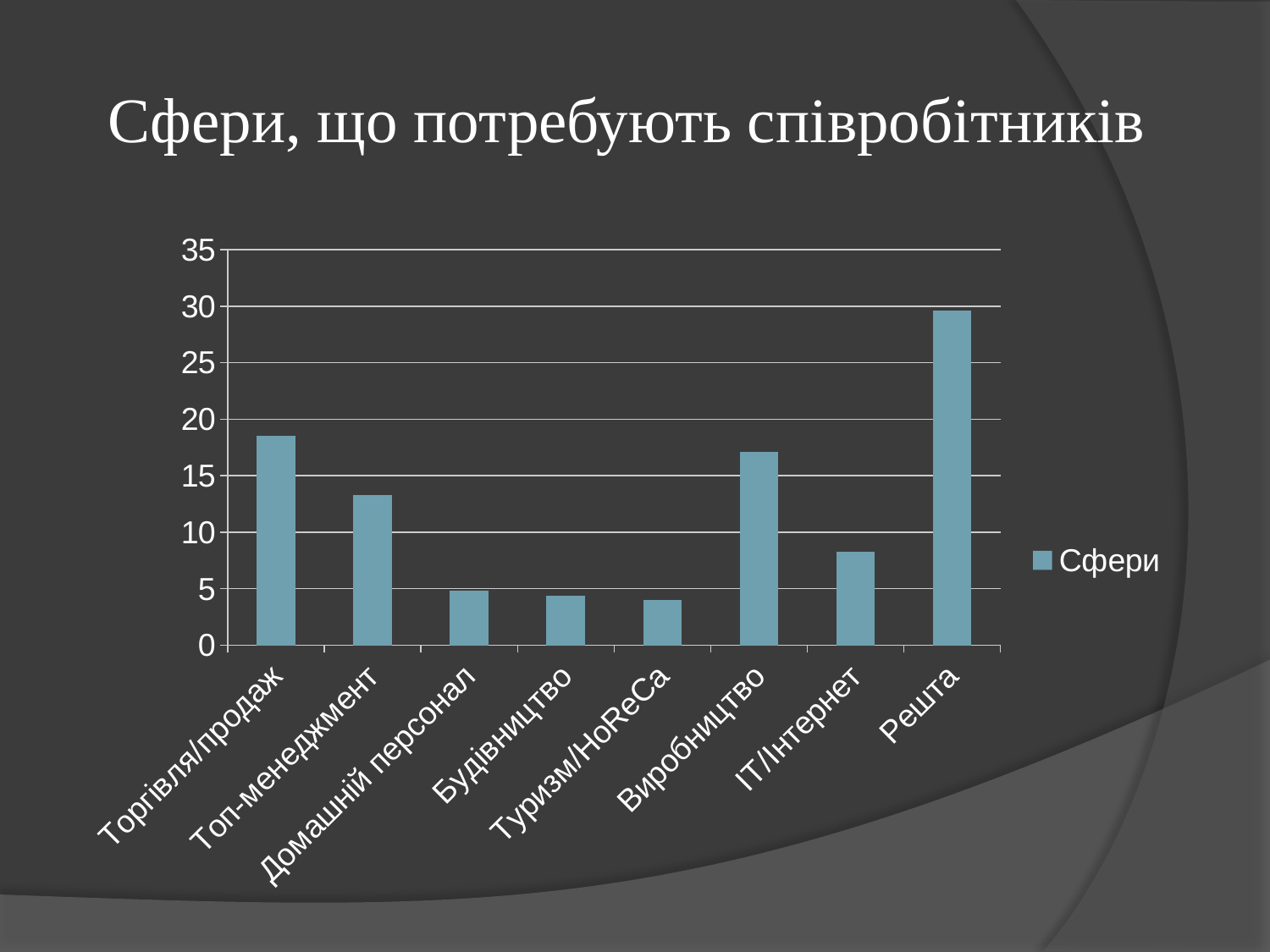
Which is larger, the value for Торгівля/продаж or the value for Топ-менеджмент? Торгівля/продаж Is the value for Домашній персонал greater or less than 10? less Is the value for Торгівля/продаж greater or less than 15? greater How many categories are shown on the x axis of the chart? 8 What is the title of the chart? Сфери, що потребують співробітників Is the value for Решта greater or less than 25? greater Which category has the highest value? Решта Which is larger, the value for Виробництво or the value for IT/Інтернет? Виробництво What is the name of the series shown in the legend? Сфери What kind of chart is shown on the slide? bar chart How many series does the legend list? 1